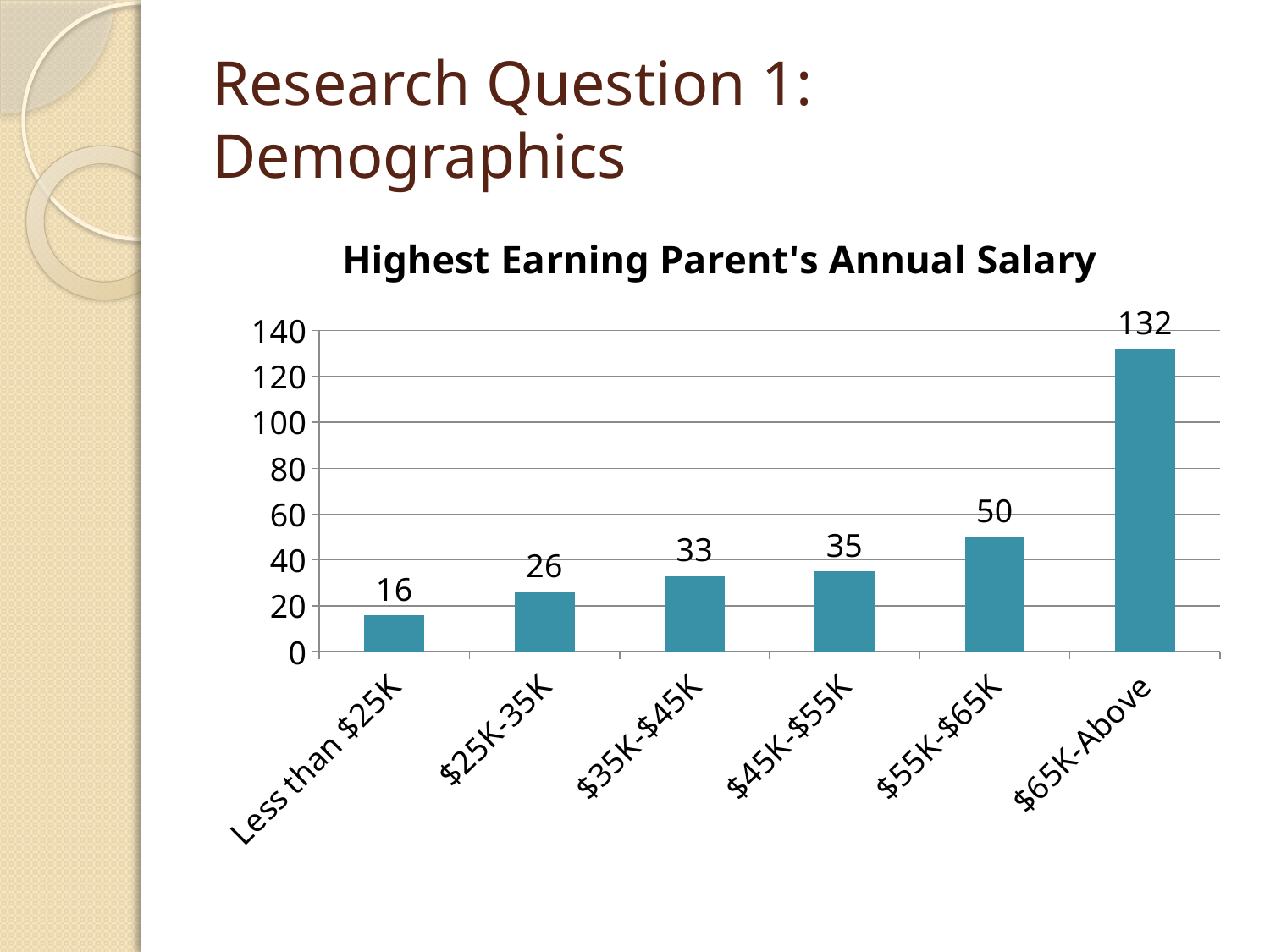
Which category has the highest value? $65K-Above What is the value for the $65K-Above category? 132 What is the title of the chart? Highest Earning Parent's Annual Salary Which is larger, the value for $55K-$65K or the value for $35K-$45K? $55K-$65K What is the difference between the values for $65K-Above and $55K-$65K? 82 What is the value for the $45K-$55K category? 35 What is the difference between the values for $25K-35K and Less than $25K? 10 How many salary categories are shown in the chart? 6 Is the value for $65K-Above greater or less than 120? greater Which category has the lowest value? Less than $25K What is the value for the Less than $25K category? 16 What kind of chart is shown on the slide? bar chart